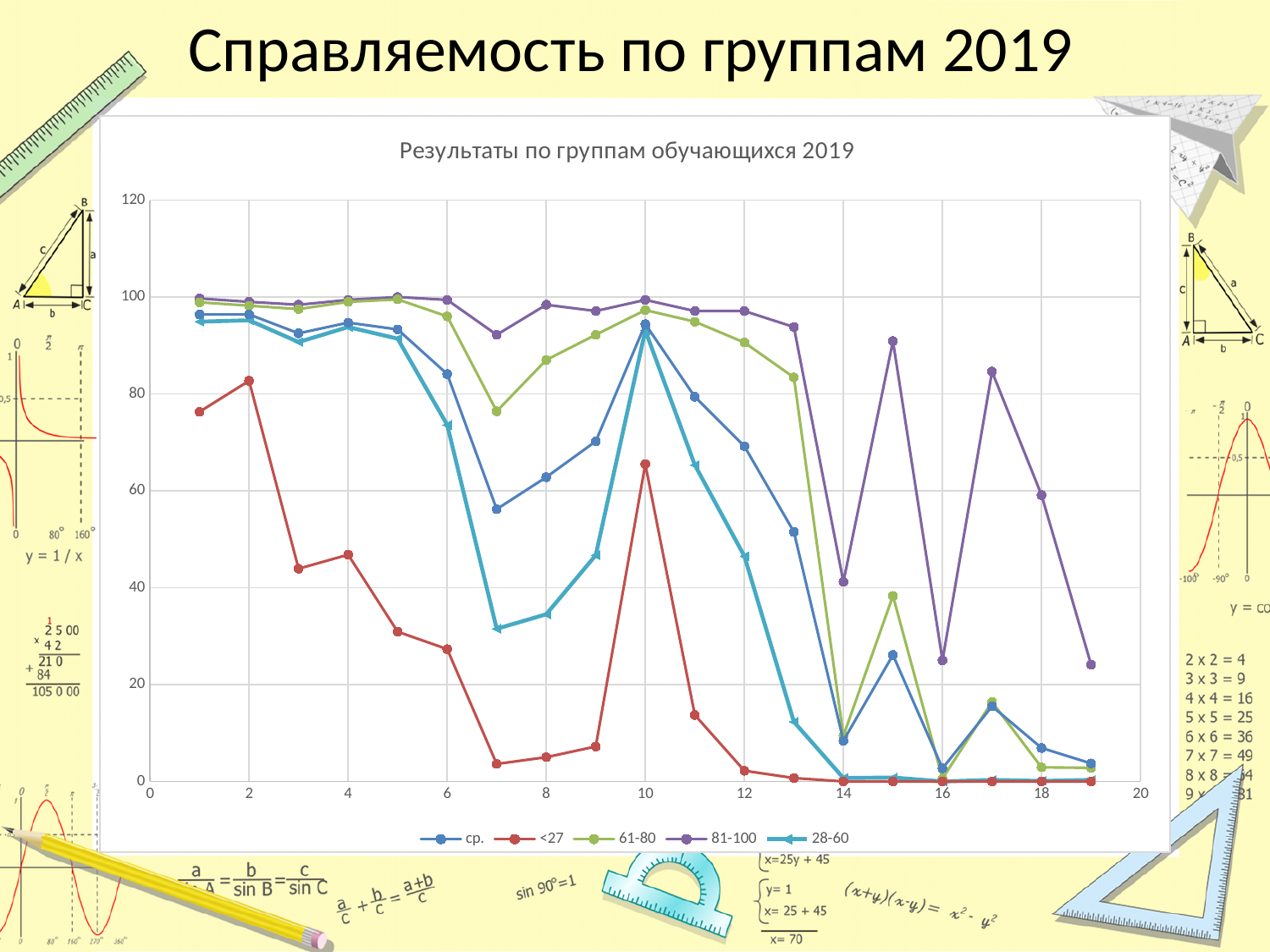
At x = 10, which series has the larger value, "<27" or "61-80"? 61-80 Is the value for the "61-80" series at x = 6 greater or less than 80? greater Is the value for the "<27" series at x = 1 greater or less than 60? greater Is the value for the "81-100" series at x = 15 greater or less than 80? greater How many series does the legend list? 5 What kind of chart is shown on the slide? line chart Which series has the highest value at x = 15? 81-100 What is the title of the chart? Результаты по группам обучающихся 2019 Does the "<27" series generally rise or fall from x = 2 to x = 7? fall At x = 14, which series has the larger value, "81-100" or "ср."? 81-100